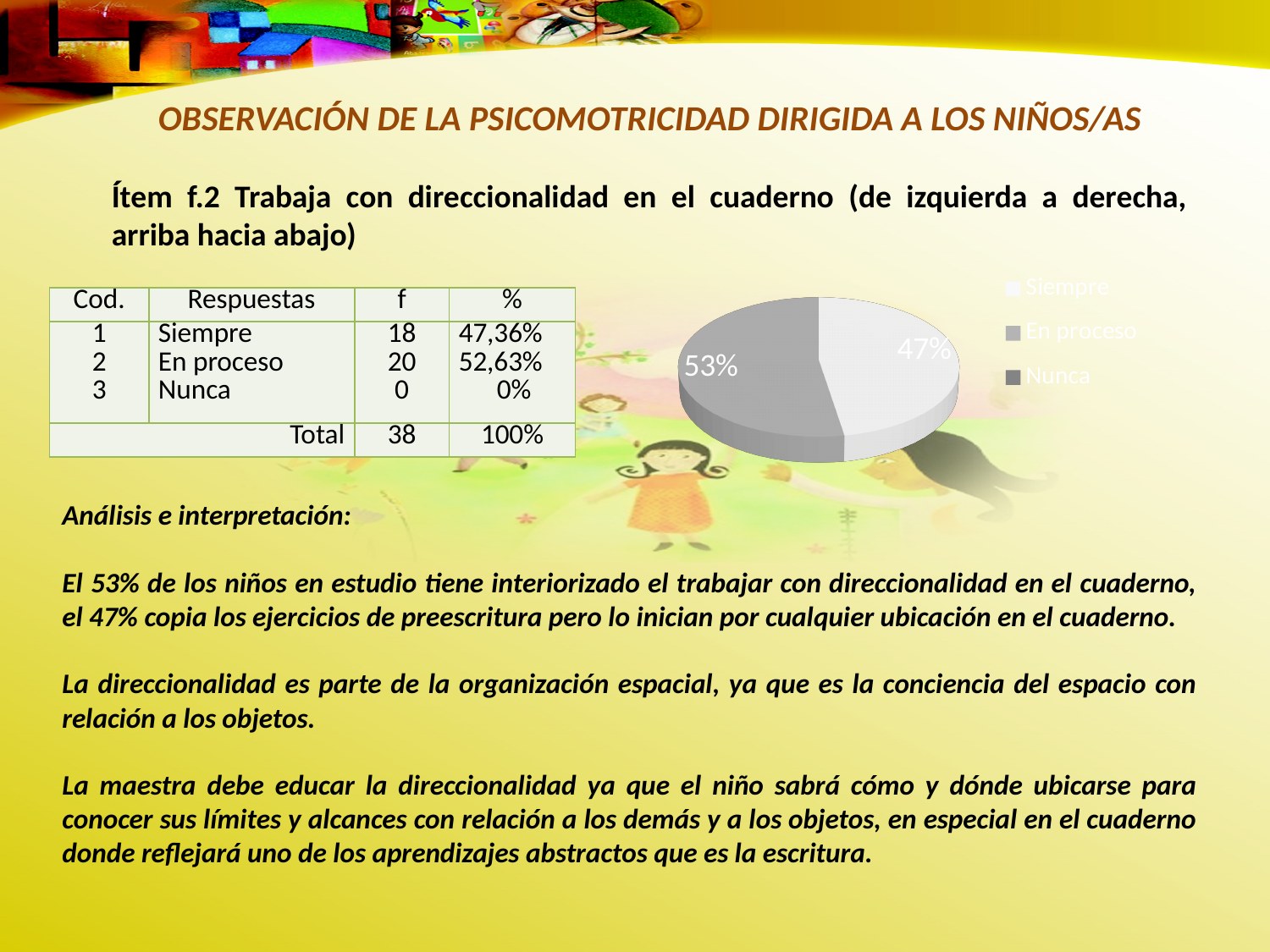
What share of the pie does the En proceso slice represent? 53% What colour is the En proceso slice in the pie chart? gray Which category has the largest slice in the pie chart? En proceso Is the share for Siempre greater or less than 50%? less Which legend entry has no visible slice in the pie chart? Nunca How many entries does the legend of the pie chart list? 3 Which is larger in the pie chart, the Siempre slice or the En proceso slice? En proceso What kind of chart is shown on the slide? pie chart What is the difference in percentage points between the En proceso slice and the Siempre slice? 6% What share of the pie does the Siempre slice represent? 47% How many slices are visibly plotted in the pie chart? 2